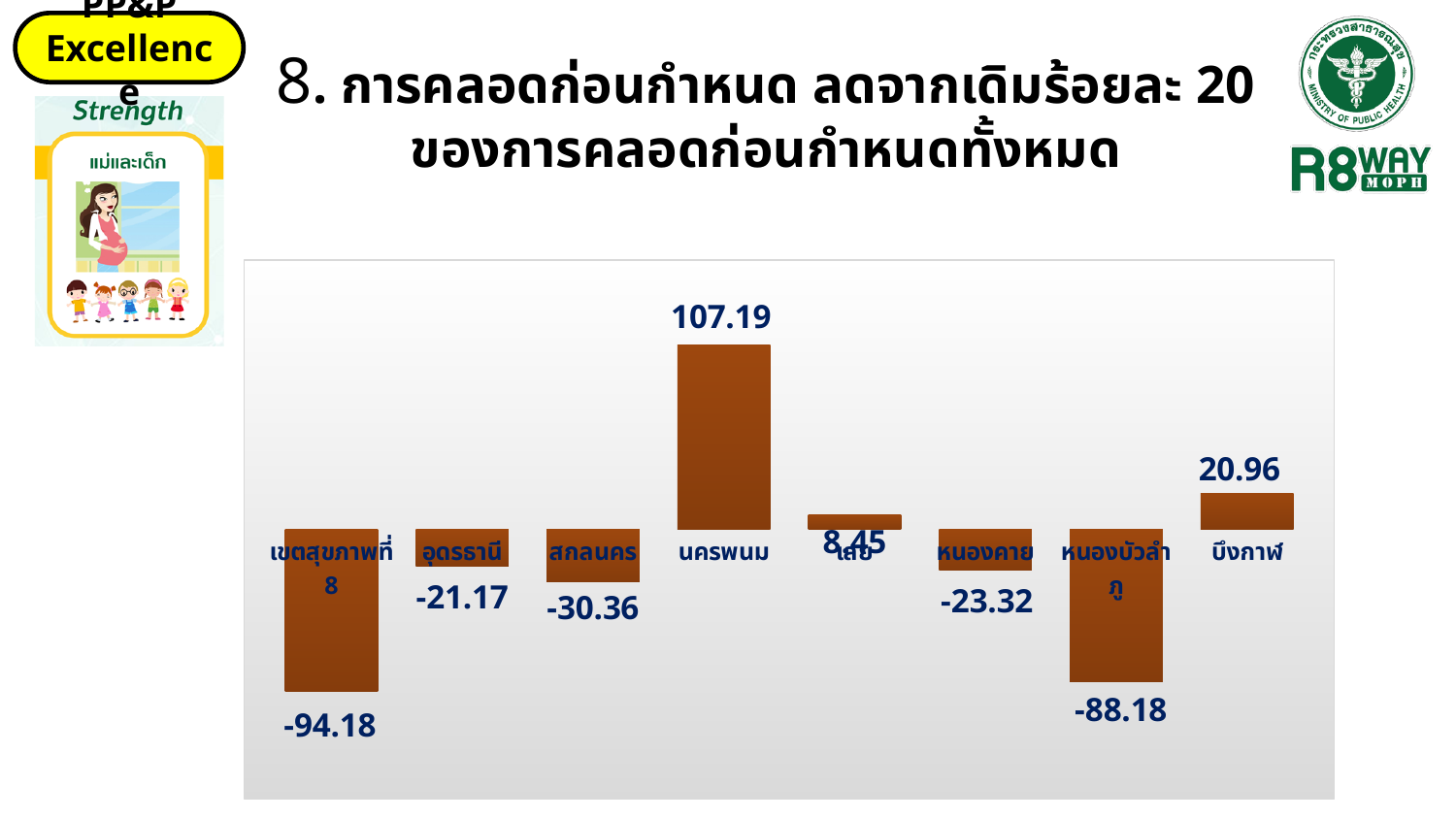
What is the value for เขตสุขภาพที่ 8? -94.18 What is the value for นครพนม? 107.19 What is the value for บึงกาฬ? 20.96 What is the difference between the values for เขตสุขภาพที่ 8 and หนองบัวลำภู? 6.00 What is the value for หนองบัวลำภู? -88.18 What is the value for สกลนคร? -30.36 Which is larger, the value for อุดรธานี or the value for หนองคาย? อุดรธานี Which category has the highest value? นครพนม How many categories are shown in the chart? 8 Which category has the lowest value? เขตสุขภาพที่ 8 What kind of chart is shown on the slide? bar chart What is the difference between the values for นครพนม and บึงกาฬ? 86.23